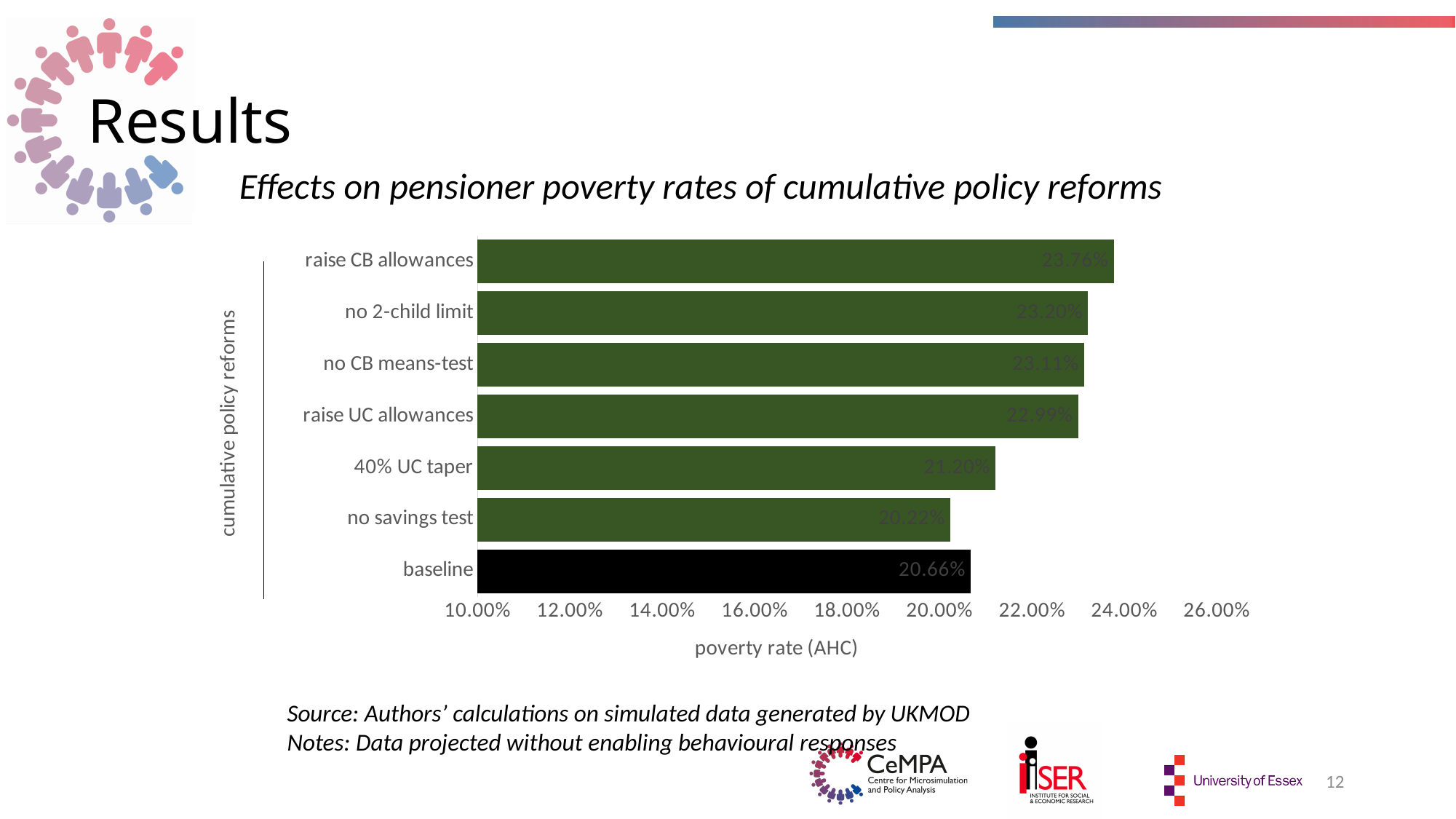
What is the poverty rate (AHC) for '40% UC taper'? 21.20% Is the poverty rate for 'raise UC allowances' greater or less than 22.00%? greater How many policy reform categories are shown on the chart? 7 Which has a higher poverty rate (AHC): 'no savings test' or 'baseline'? baseline What is the label of the horizontal axis of the chart? poverty rate (AHC) What is the poverty rate (AHC) after the 'raise CB allowances' reform? 23.76% What is the poverty rate (AHC) for the baseline? 20.66% Which policy reform has the highest poverty rate (AHC)? raise CB allowances What kind of chart is shown on the slide? bar chart Which category has the lowest poverty rate (AHC)? no savings test By how many percentage points does the poverty rate for 'raise CB allowances' exceed the baseline? 3.10 percentage points What is the poverty rate (AHC) for 'no savings test'? 20.22%